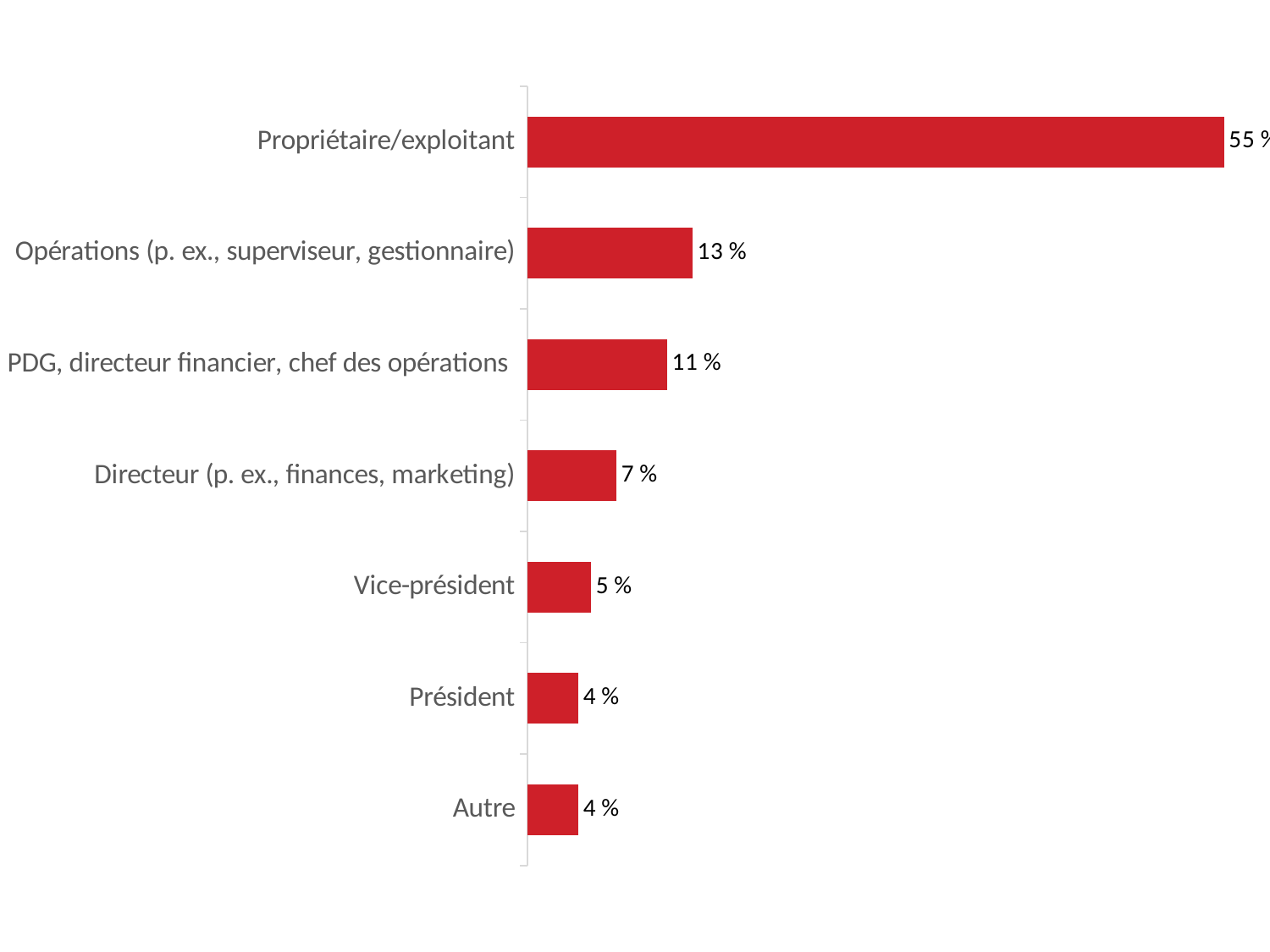
What kind of chart is shown on the slide? Bar chart Which is larger, the value for Vice-président or the value for Président? Vice-président What colour are the bars in the chart? Red What is the value for PDG, directeur financier, chef des opérations? 11 % Which category has the highest value? Propriétaire/exploitant What is the difference between the values for Directeur (p. ex., finances, marketing) and Vice-président? 2 % What is the value for Président? 4 % What is the difference between the values for Opérations (p. ex., superviseur, gestionnaire) and PDG, directeur financier, chef des opérations? 2 % What is the value for Directeur (p. ex., finances, marketing)? 7 % How many categories are shown in the chart? 7 What is the value for Vice-président? 5 % What is the value for Opérations (p. ex., superviseur, gestionnaire)? 13 %